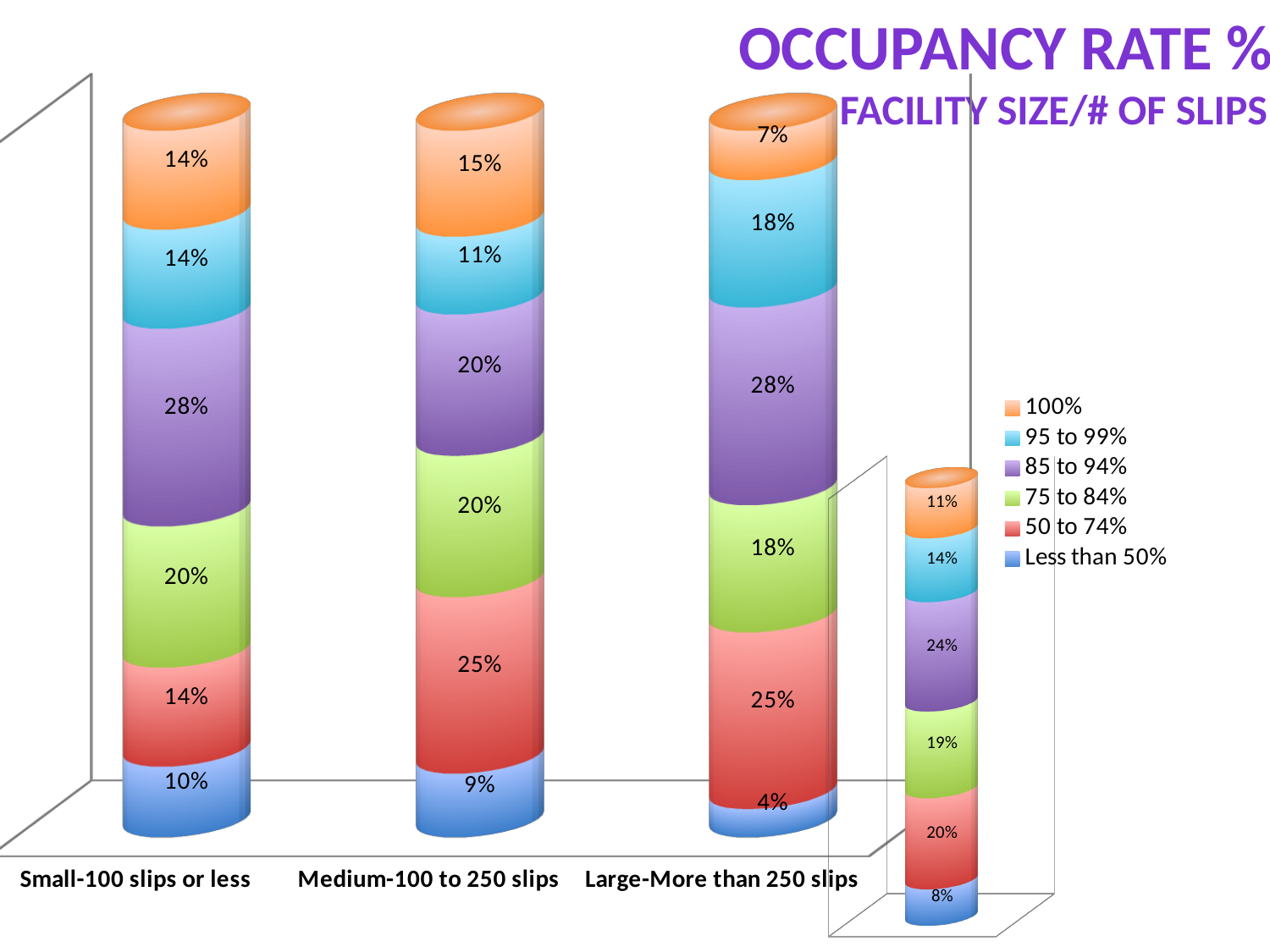
In the main chart, which facility size has the lowest value for the Less than 50% segment? Large-More than 250 slips In the main chart, what is the difference between the 100% segment for Small-100 slips or less and for Large-More than 250 slips? 7 percentage points What kind of chart is the main chart on the slide? Stacked bar chart How many facility size categories are shown on the x axis of the main chart? 3 In the small chart at the bottom right, what is the value of the 85 to 94% (purple) segment? 24% In the main chart, what is the value of the Less than 50% segment for Large-More than 250 slips? 4% In the main chart, what is the value of the 85 to 94% segment for Small-100 slips or less? 28% How many series does the legend list? 6 In the main chart, is the 75 to 84% segment larger for Medium-100 to 250 slips or for Large-More than 250 slips? Medium-100 to 250 slips In the main chart, what is the value of the 100% segment for Large-More than 250 slips? 7% In the main chart, what is the value of the 50 to 74% segment for Medium-100 to 250 slips? 25% In the main chart, which facility size has the highest value for the 95 to 99% segment? Large-More than 250 slips